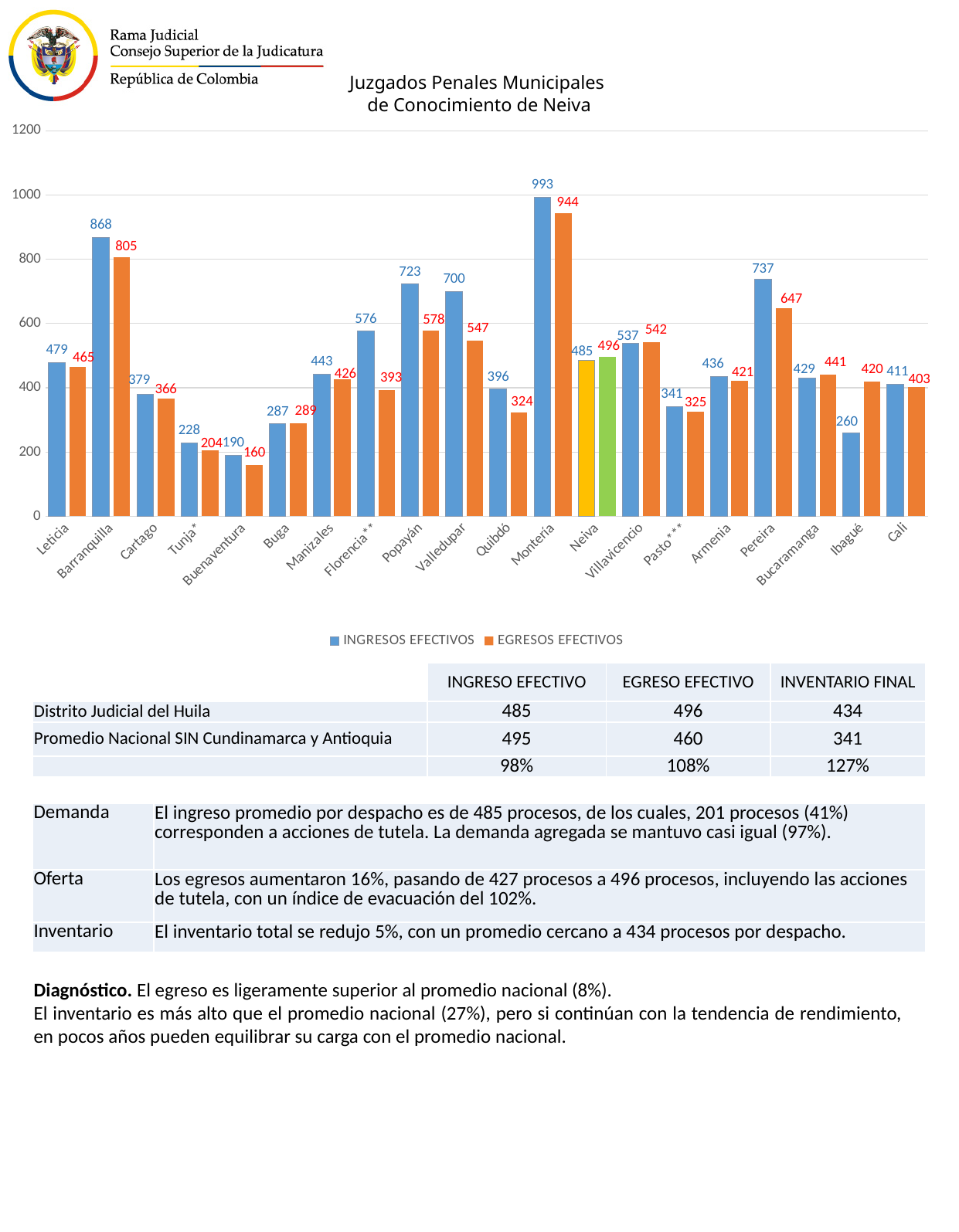
How many cities are shown on the x axis of the chart? 20 What is the difference between INGRESOS EFECTIVOS and EGRESOS EFECTIVOS for Florencia**? 183 Which city has the lowest EGRESOS EFECTIVOS value? Buenaventura How many series does the chart legend list? 2 Which city has the highest INGRESOS EFECTIVOS value? Montería For Neiva, which is larger: INGRESOS EFECTIVOS or EGRESOS EFECTIVOS? EGRESOS EFECTIVOS What type of chart is shown on the slide? Bar chart What is the EGRESOS EFECTIVOS value for Neiva? 496 What is the INGRESOS EFECTIVOS value for Ibagué? 260 What is the INGRESOS EFECTIVOS value for Montería? 993 What is the difference between INGRESOS EFECTIVOS and EGRESOS EFECTIVOS for Barranquilla? 63 Which city has the larger INGRESOS EFECTIVOS value, Popayán or Valledupar? Popayán